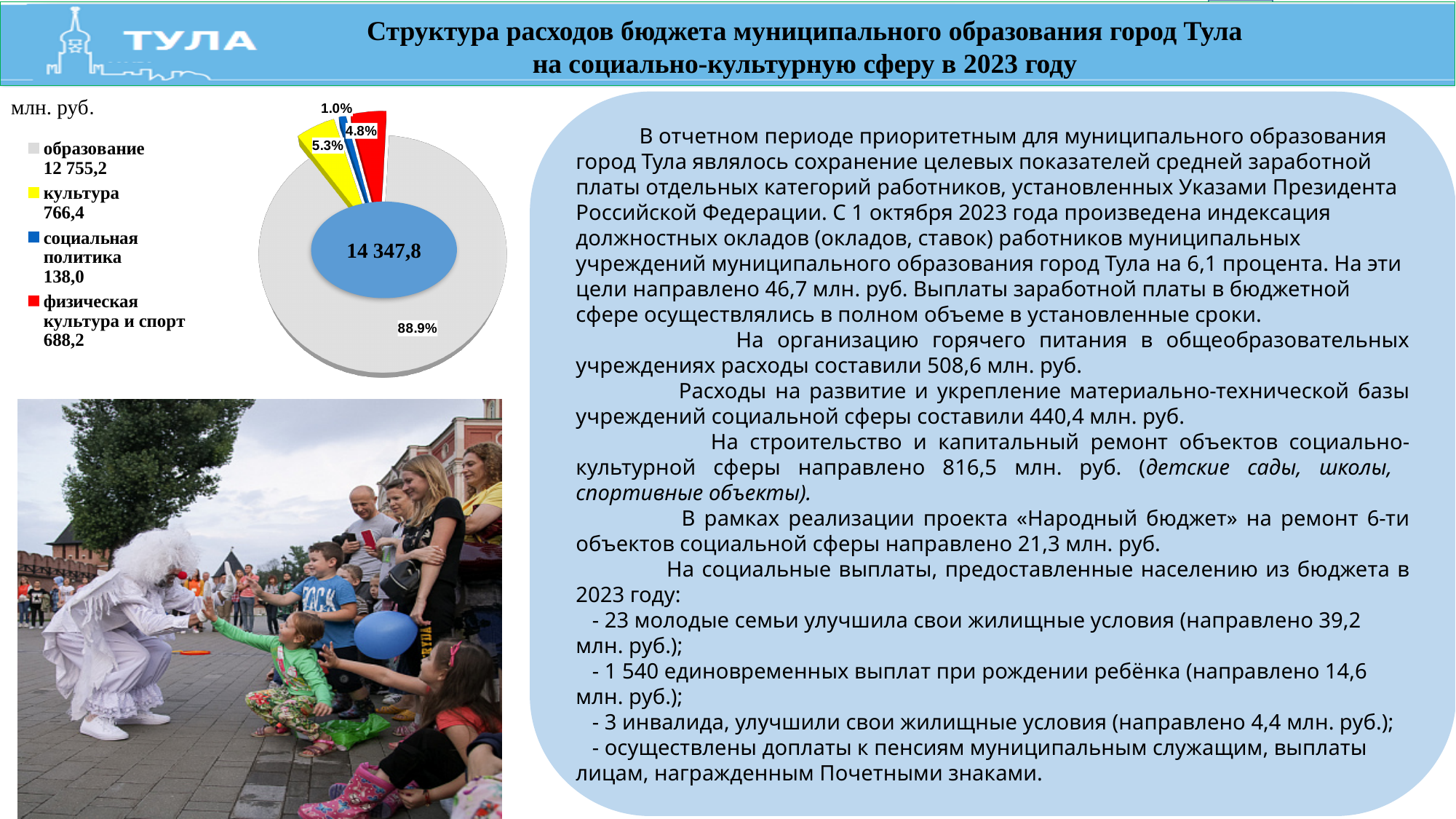
How many categories does the pie chart show? 4 What total value is printed in the centre of the pie chart? 14 347,8 What is the value for образование in the pie chart? 12 755,2 What percentage share of the pie does физическая культура и спорт have? 4.8% Which category has the largest share of the pie chart? образование What percentage share of the pie does образование have? 88.9% What is the value for социальная политика in the pie chart? 138,0 What is the value for физическая культура и спорт in the pie chart? 688,2 Which is larger, the value for культура or the value for физическая культура и спорт? культура What kind of chart is shown on the slide? pie chart Which category has the smallest share of the pie chart? социальная политика What is the value for культура in the pie chart? 766,4